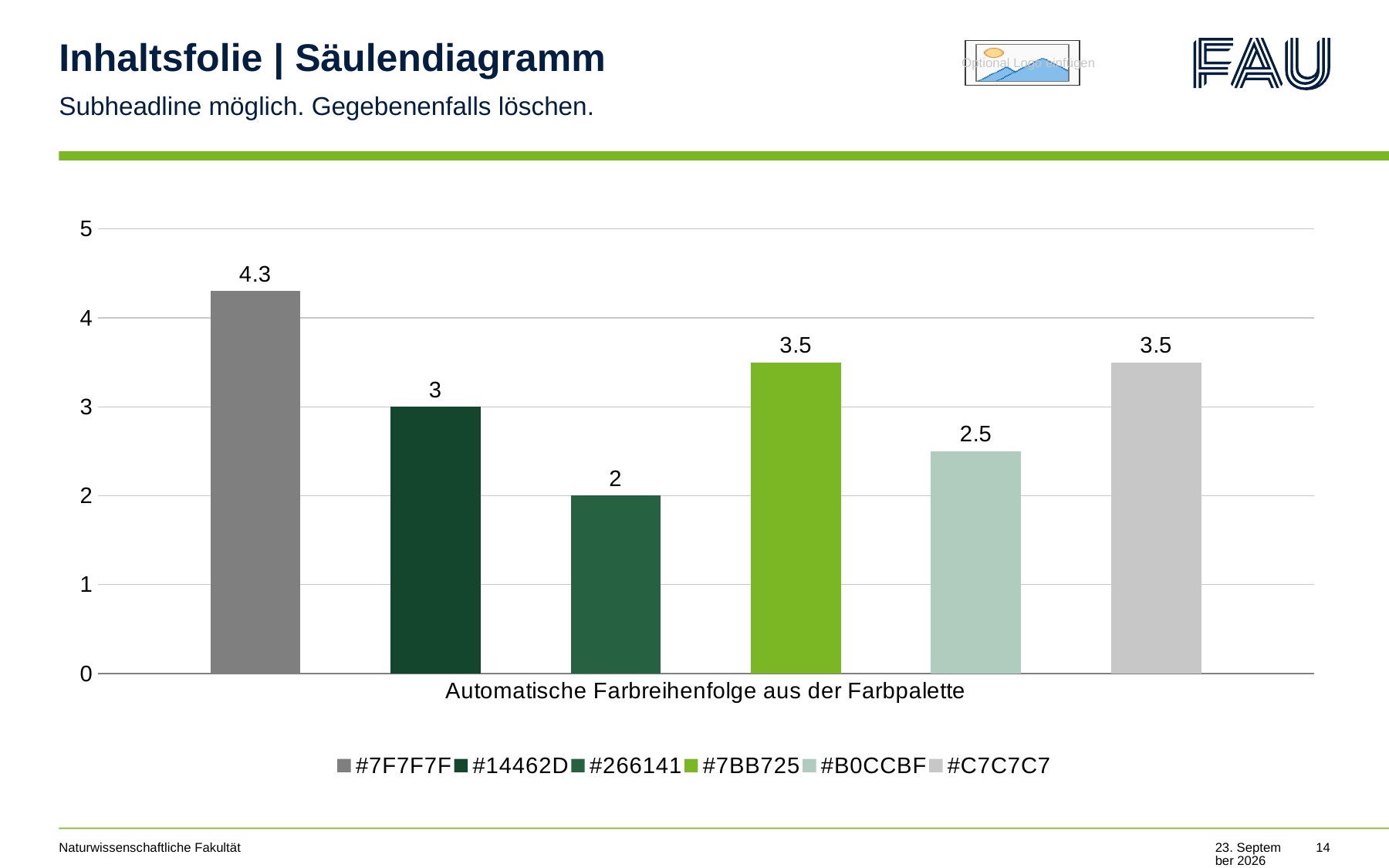
What is the value for the series #7F7F7F? 4.3 Which series has the lowest value? #266141 What is the value for the series #266141? 2 What is the category label shown on the x axis? Automatische Farbreihenfolge aus der Farbpalette Which series has the highest value? #7F7F7F Which two series share the value 3.5? #7BB725 and #C7C7C7 What is the difference between the values for #7BB725 and #B0CCBF? 1 What is the difference between the values for #7F7F7F and #14462D? 1.3 What is the value for the series #B0CCBF? 2.5 What kind of chart is shown on the slide? bar chart Which is larger, the value for #14462D or the value for #B0CCBF? #14462D How many series does the legend list? 6